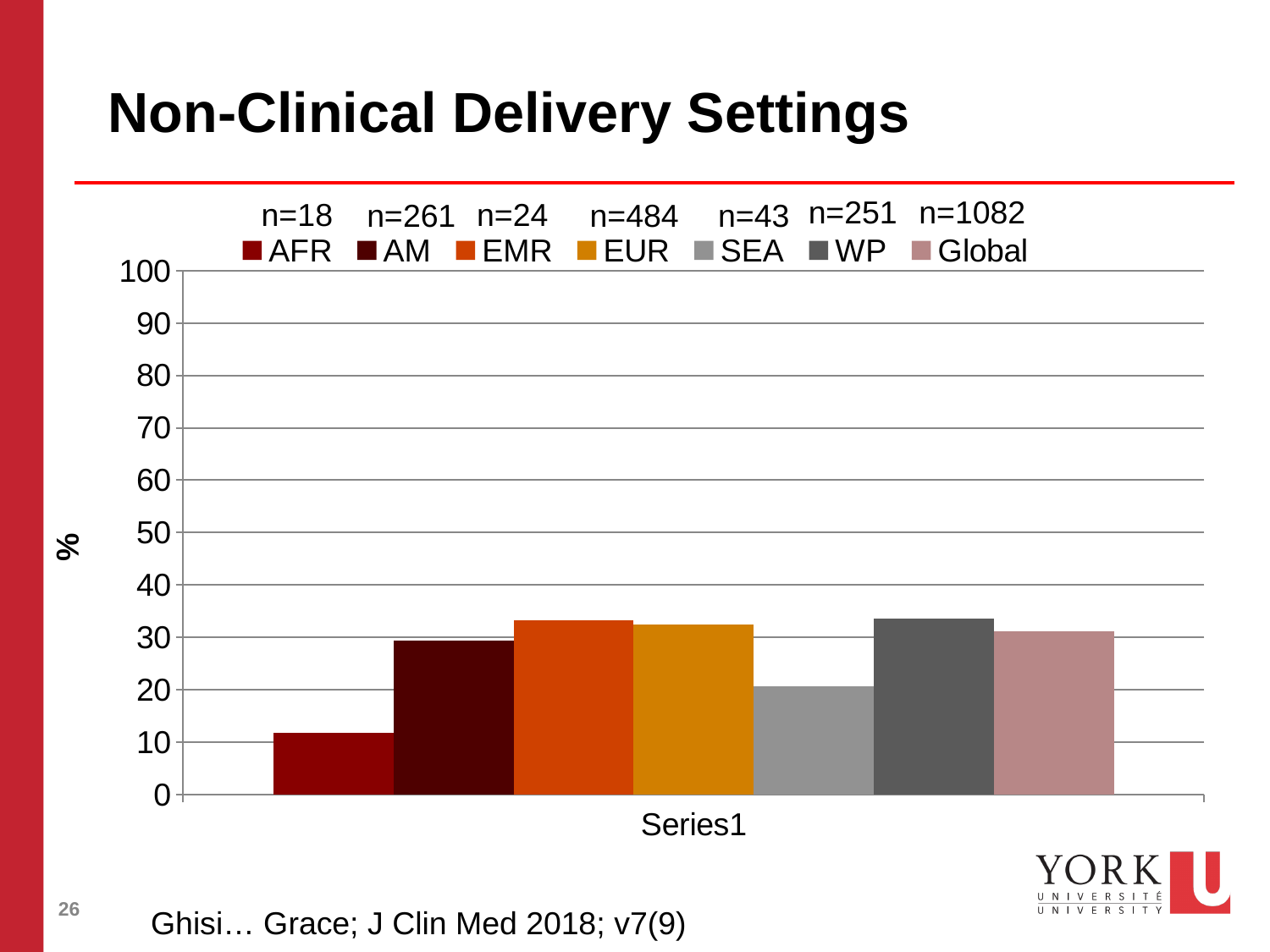
Is the value for WP greater or less than 40? less Which is larger, the value for AM or the value for SEA? AM Is the value for AFR greater or less than 20? less Is the value for SEA greater or less than 30? less Which is larger, the value for AFR or the value for Global? Global What is the title of the slide containing the chart? Non-Clinical Delivery Settings What kind of chart is shown on the slide? bar chart How many series does the legend list? 7 Which series has the lowest value? AFR What sample size (n) is shown above the Global legend entry? n=1082